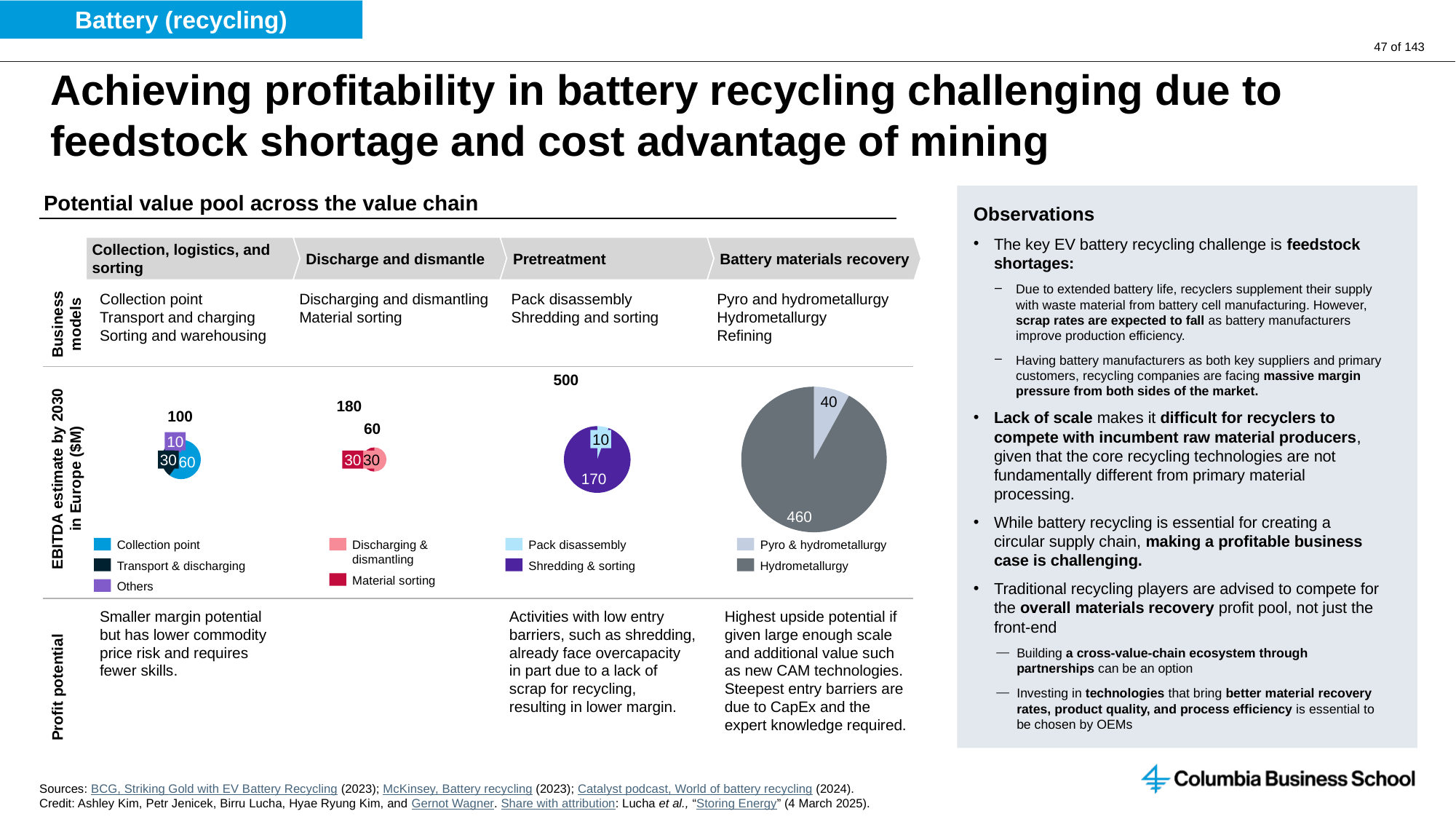
In the Battery materials recovery pie chart, what is the value for Pyro & hydrometallurgy? 40 In the Pretreatment pie chart, which segment is the largest? Shredding & sorting In the Collection, logistics, and sorting pie chart, what is the value for Transport & discharging? 30 In the Collection, logistics, and sorting pie chart, which segment is the smallest? Others In the Pretreatment pie chart, what is the value for Shredding & sorting? 170 In the Discharge and dismantle pie chart, what is the total of Discharging & dismantling and Material sorting? 60 In the Collection, logistics, and sorting pie chart, what is the value for Collection point? 60 How many segments does the Discharge and dismantle pie chart have? 2 In the Collection, logistics, and sorting pie chart, what is the value for Others? 10 In the Battery materials recovery pie chart, what is the value for Hydrometallurgy? 460 In the Battery materials recovery pie chart, what is the difference between Hydrometallurgy and Pyro & hydrometallurgy? 420 What kind of charts are used to show the EBITDA estimate by 2030 in Europe? Pie charts